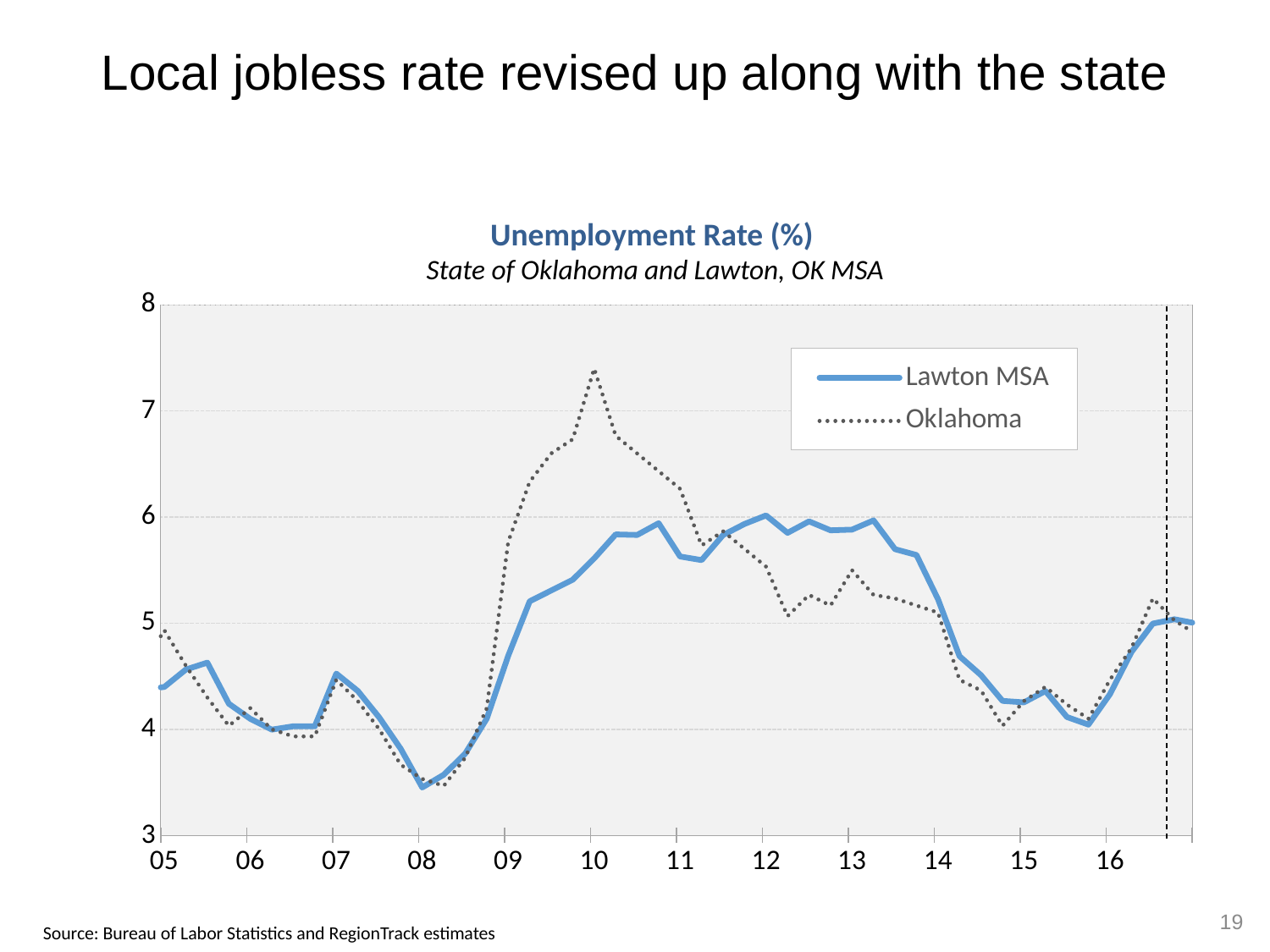
Which series reaches the highest value anywhere on the chart? Oklahoma What kind of chart is shown on the slide? line chart What are the two series named in the legend? Lawton MSA and Oklahoma How many series does the legend list? 2 Is the Oklahoma value at 11 greater or less than 6? greater At 10, which series has the higher unemployment rate, Lawton MSA or Oklahoma? Oklahoma Is the Lawton MSA value at its low point around 2008 greater or less than 4? less Is the Lawton MSA value at 10 greater or less than 5? greater At 12, which series has the higher unemployment rate, Lawton MSA or Oklahoma? Lawton MSA What is the title of the chart? Unemployment Rate (%) Does the Lawton MSA line rise or fall between 13 and 15? fall